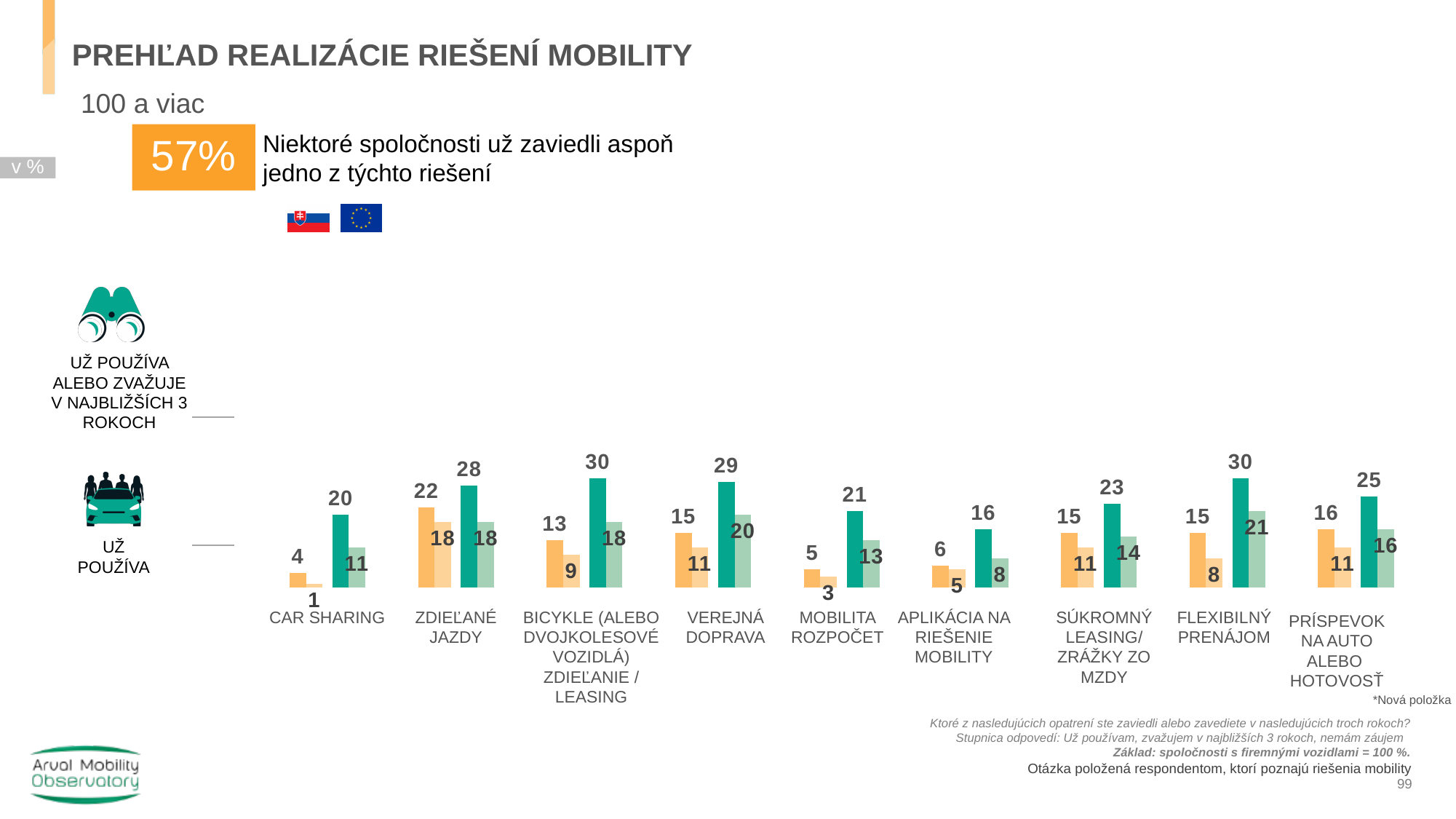
What is the value of the light green bar for FLEXIBILNÝ PRENÁJOM? 21 What is the value of the dark green bar for ZDIEĽANÉ JAZDY? 28 What is the value of the light orange bar for BICYKLE (ALEBO DVOJKOLESOVÉ VOZIDLÁ) ZDIEĽANIE / LEASING? 9 Which category has the highest dark orange bar? ZDIEĽANÉ JAZDY How many categories (mobility solutions) are shown along the x axis of the chart? 9 What is the difference between the dark green bar and the dark orange bar for ZDIEĽANÉ JAZDY? 6 What percentage is highlighted in the orange box at the top of the slide? 57% Which category has the lowest light orange bar? CAR SHARING What type of chart is shown on the slide? bar chart Which is larger: the dark green bar for VEREJNÁ DOPRAVA or the dark green bar for MOBILITA ROZPOČET? VEREJNÁ DOPRAVA Which category has the lowest dark green bar? APLIKÁCIA NA RIEŠENIE MOBILITY What is the value of the dark orange bar for CAR SHARING? 4